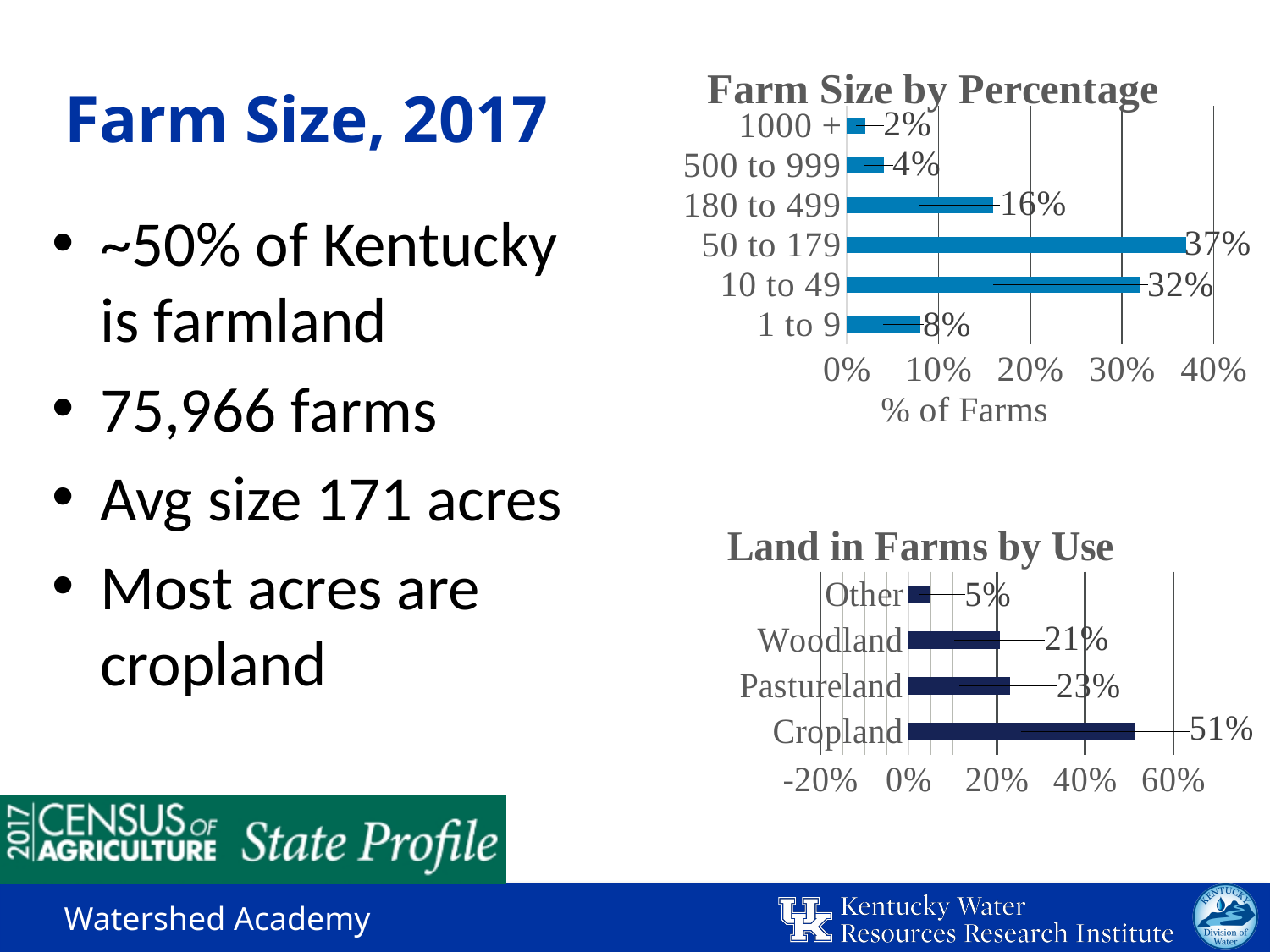
What type of chart is the 'Land in Farms by Use' chart? Bar chart In the 'Farm Size by Percentage' chart, what percentage of farms are 1000 + acres? 2% In the 'Land in Farms by Use' chart, what percentage of land is Cropland? 51% In the 'Land in Farms by Use' chart, what is the difference between Cropland and Pastureland? 28% In the 'Land in Farms by Use' chart, what percentage of land is Woodland? 21% In the 'Farm Size by Percentage' chart, which farm size category has the lowest percentage of farms? 1000 + In the 'Farm Size by Percentage' chart, what percentage of farms are 50 to 179 acres? 37% In the 'Farm Size by Percentage' chart, how many farm size categories are shown? 6 In the 'Farm Size by Percentage' chart, which is larger: 180 to 499 or 1 to 9? 180 to 499 In the 'Land in Farms by Use' chart, which land use has the lowest percentage? Other In the 'Farm Size by Percentage' chart, what is the difference between the 50 to 179 and 10 to 49 categories? 5% In the 'Farm Size by Percentage' chart, which farm size category has the highest percentage of farms? 50 to 179